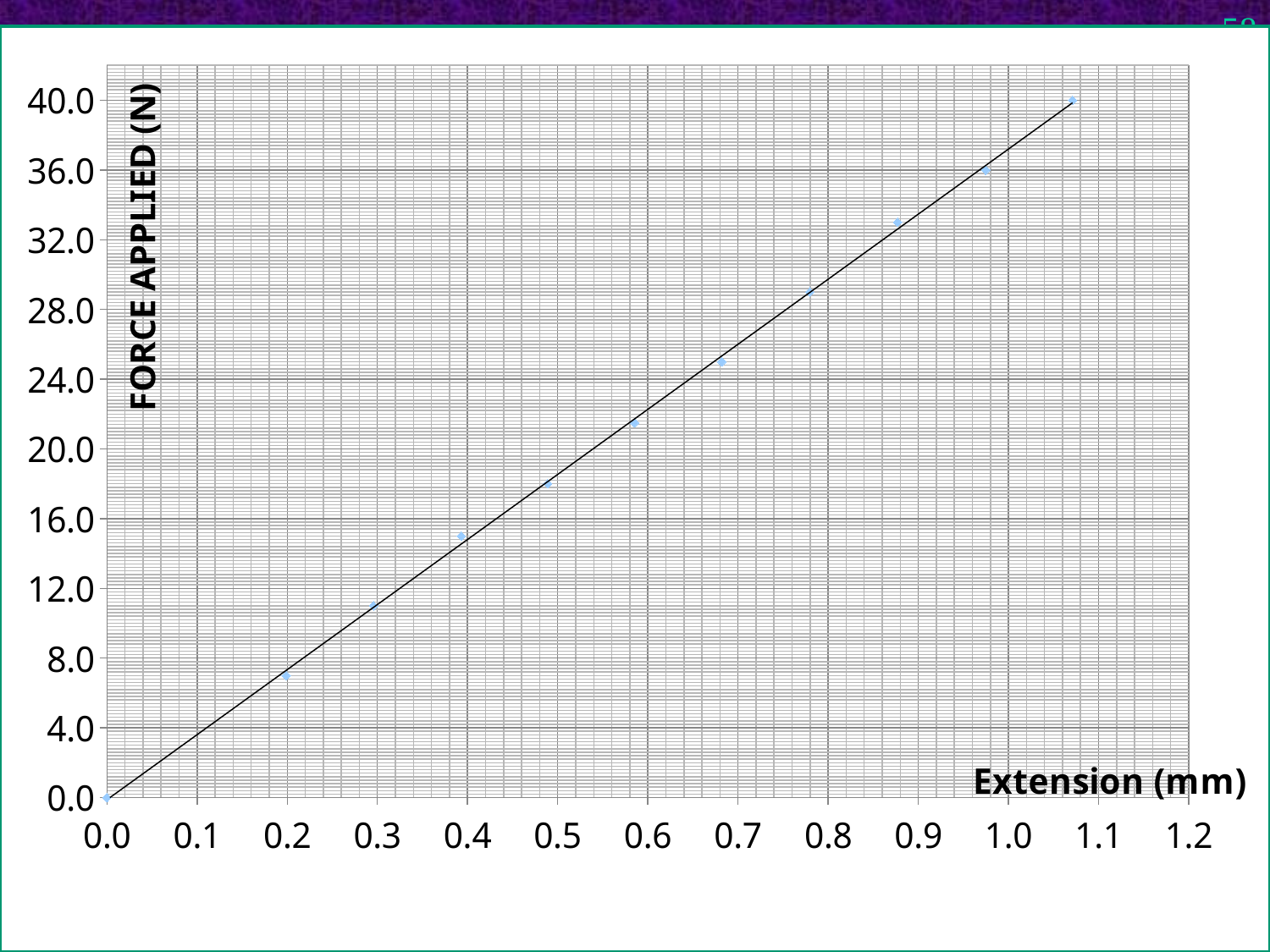
What is the label of the x axis? Extension (mm) What is the highest force value plotted on the chart? 40.0 Is the force applied at an extension of 0.7 mm greater or less than 20.0 N? greater Is the force applied at an extension of 0.2 mm greater or less than 8.0 N? less What is the lowest force value plotted on the chart? 0.0 Which is larger, the force at an extension of 0.9 mm or the force at an extension of 0.4 mm? 0.9 mm What is the label of the y axis? FORCE APPLIED (N) What kind of chart is shown on the slide? scatter chart Does the force applied rise or fall as the extension increases? rise Is the force applied at an extension of 0.3 mm greater or less than 12.0 N? less How many data points are plotted on the chart? 11